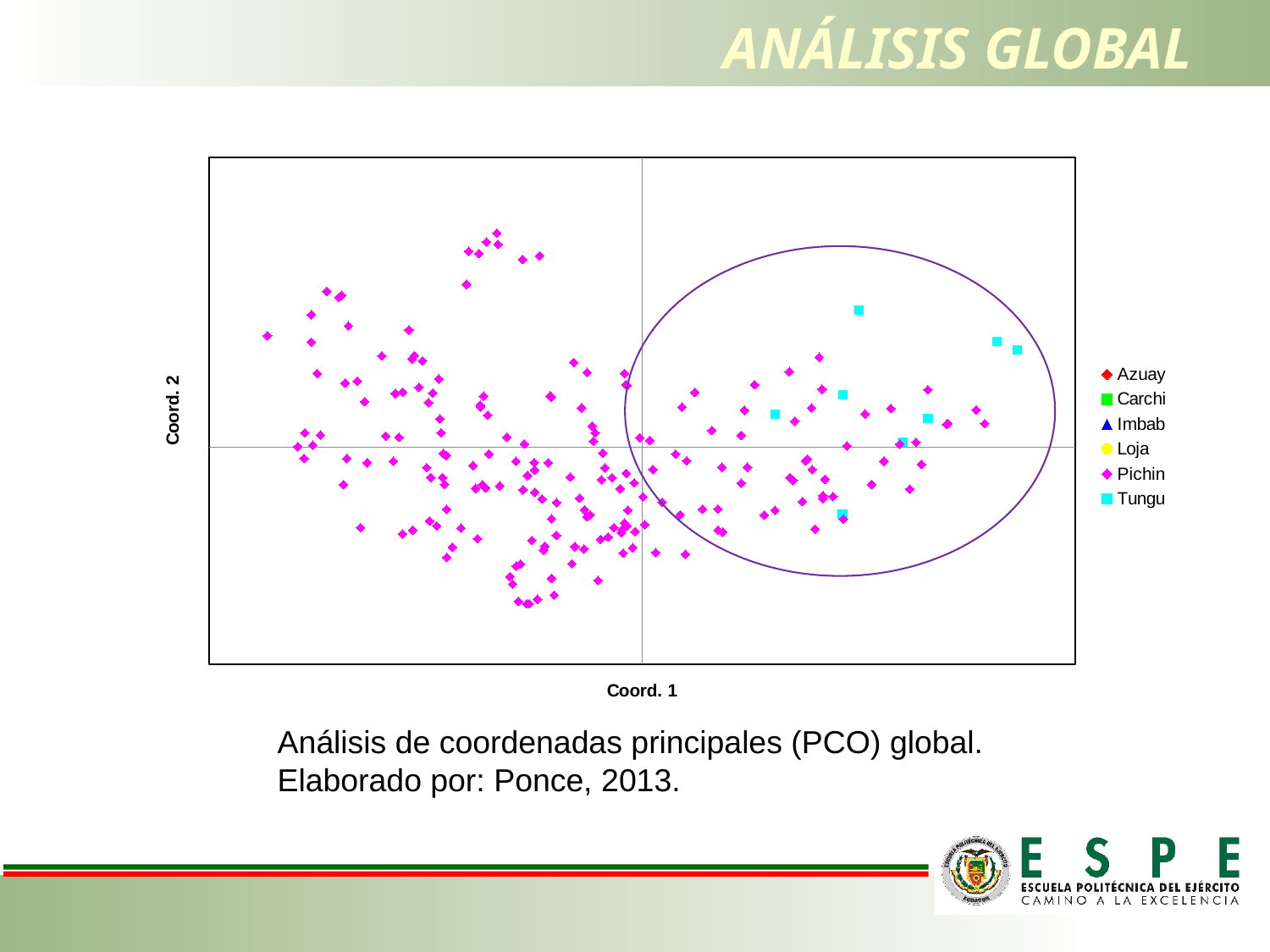
Which series is represented by cyan squares in the legend? Tungu What is the label of the vertical axis? Coord. 2 Which series' points all lie to the right of the vertical centre line (positive Coord. 1)? Tungu What is the label of the horizontal axis? Coord. 1 How many series does the legend list? 6 Which series has more points plotted on the chart, Pichin or Tungu? Pichin What kind of chart is shown on the slide? Scatter plot